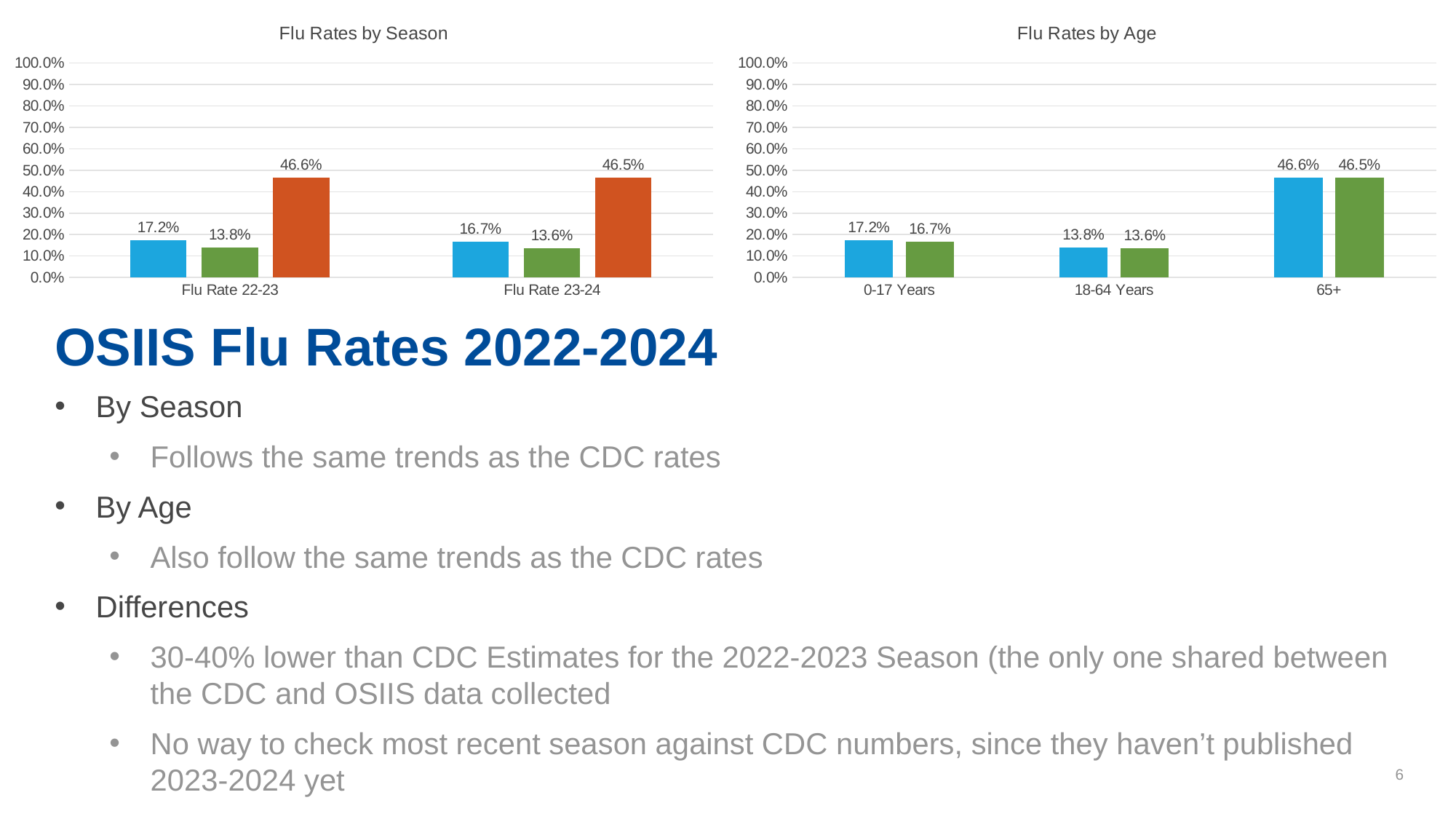
In the Flu Rates by Age chart, what is the value of the green bar for 18-64 Years? 13.6% In the Flu Rates by Season chart, what is the value of the blue bar for Flu Rate 23-24? 16.7% In the Flu Rates by Age chart, is the value of the green bar for 65+ greater or less than 40.0%? greater What kind of chart is the Flu Rates by Season chart? bar chart How many categories are shown on the x axis of the Flu Rates by Age chart? 3 In the Flu Rates by Season chart, what is the value of the orange bar for Flu Rate 22-23? 46.6% In the Flu Rates by Season chart, which is larger for Flu Rate 23-24: the blue bar or the green bar? the blue bar In the Flu Rates by Season chart, what is the difference between the orange bar and the blue bar for Flu Rate 22-23? 29.4% In the Flu Rates by Age chart, what is the difference between the blue bar and the green bar for 0-17 Years? 0.5% In the Flu Rates by Age chart, which age group has the lowest values? 18-64 Years In the Flu Rates by Age chart, which age group has the highest values? 65+ In the Flu Rates by Age chart, what is the value of the blue bar for 65+? 46.6%